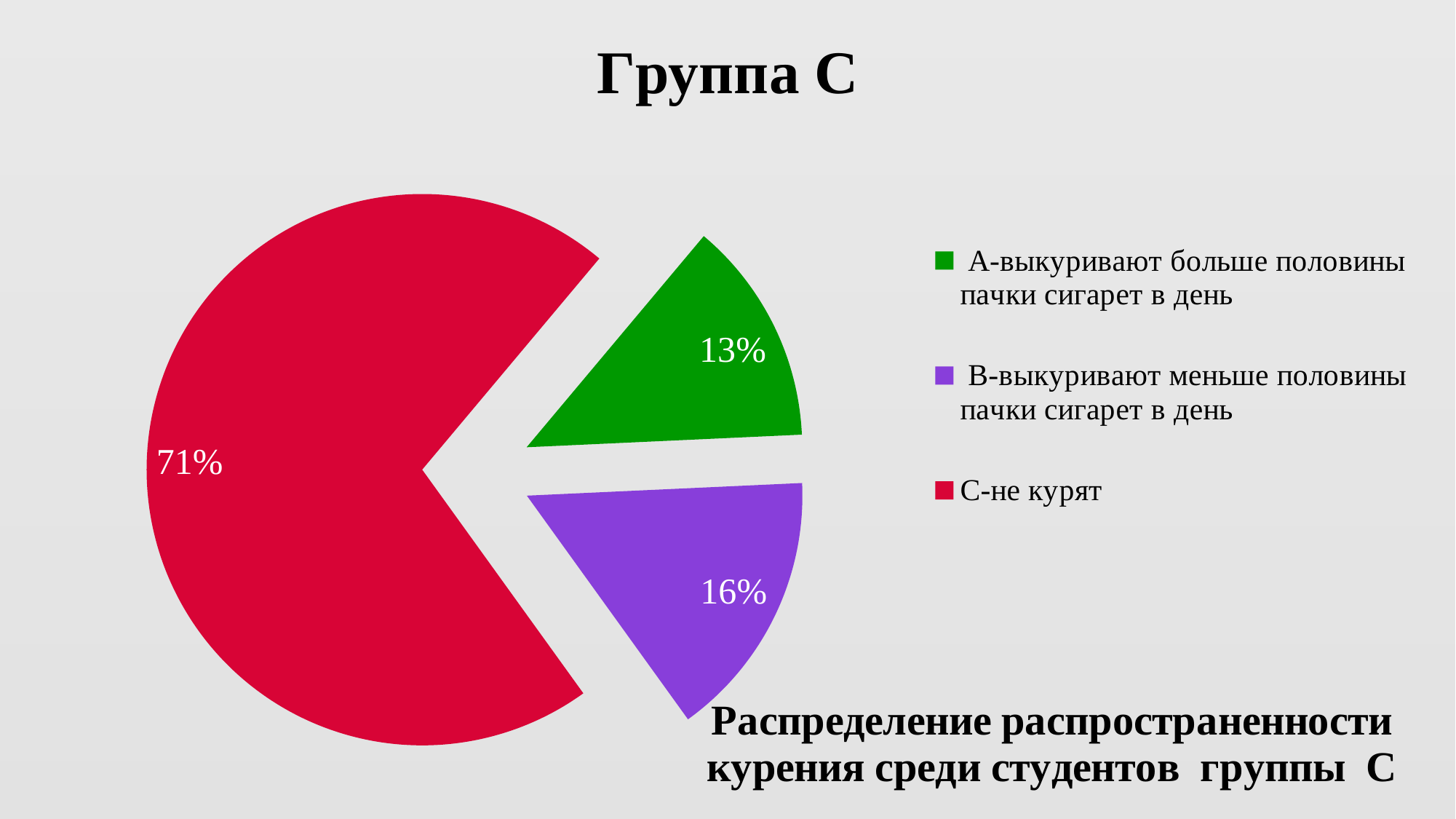
Which category has the smallest slice of the pie? А-выкуривают больше половины пачки сигарет в день What share of the pie is labelled "С-не курят"? 71% How many slices does the pie chart have? 3 Which is larger: the share for "А-выкуривают больше половины пачки сигарет в день" or the share for "В-выкуривают меньше половины пачки сигарет в день"? В-выкуривают меньше половины пачки сигарет в день What is the difference between the share for "С-не курят" and the share for "В-выкуривают меньше половины пачки сигарет в день"? 55% How many entries does the legend list? 3 What colour is the slice for "С-не курят"? red What kind of chart is shown on the slide? pie chart Which category has the largest slice of the pie? С-не курят What is the difference between the share for "В-выкуривают меньше половины пачки сигарет в день" and the share for "А-выкуривают больше половины пачки сигарет в день"? 3% What share of the pie is labelled "В-выкуривают меньше половины пачки сигарет в день"? 16% What share of the pie is labelled "А-выкуривают больше половины пачки сигарет в день"? 13%